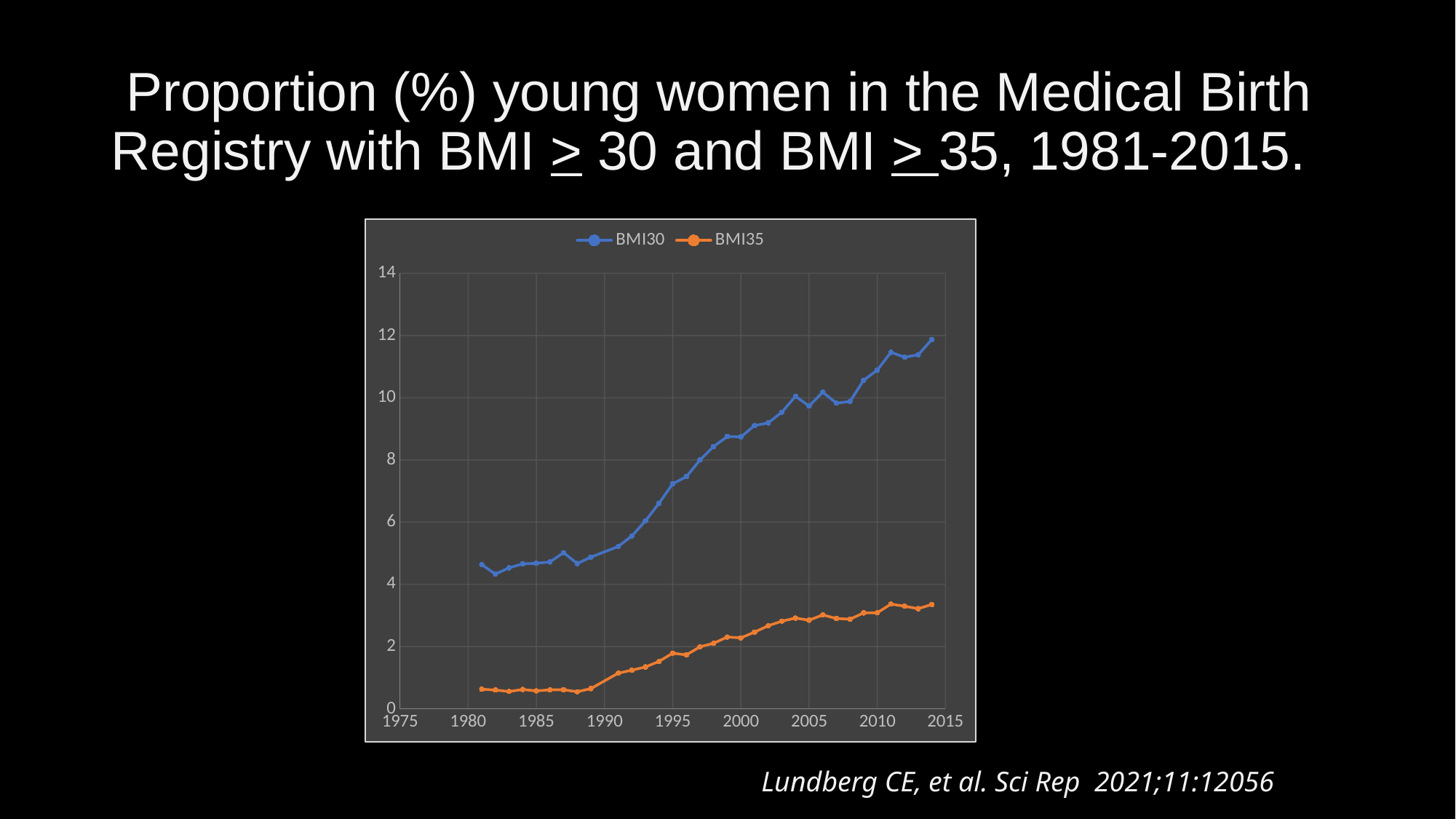
Is the value for BMI35 in 1981 greater or less than 2? less How many series does the legend list? 2 Does the BMI35 series generally rise or fall over the period shown? rise Is the value for BMI35 in 2010 greater or less than 2? greater Does the BMI30 series generally rise or fall from 1981 to 2014? rise Is the value for BMI30 in 2000 greater or less than 8? greater What are the two series named in the legend? BMI30 and BMI35 Which series is drawn in orange? BMI35 What kind of chart is shown on the slide? line chart In 2000, which series has the larger value, BMI30 or BMI35? BMI30